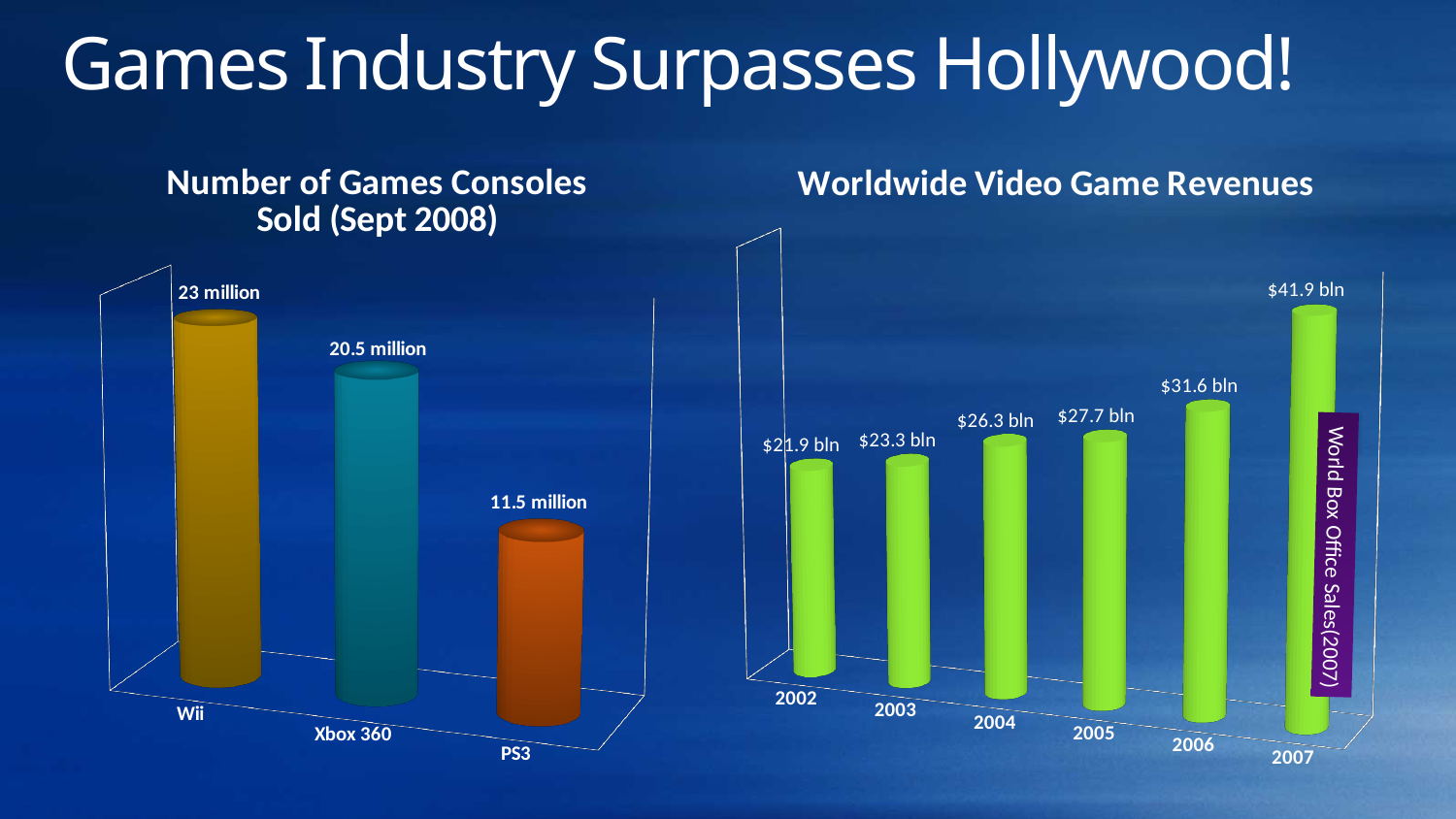
In the 'Worldwide Video Game Revenues' chart, do revenues rise or fall from 2002 to 2007? rise In the 'Number of Games Consoles Sold (Sept 2008)' chart, how many consoles were sold for the Wii? 23 million In the 'Number of Games Consoles Sold (Sept 2008)' chart, which console has the lowest number sold? PS3 In the 'Worldwide Video Game Revenues' chart, what is the difference between the 2007 and 2006 revenues? $10.3 bln In the 'Number of Games Consoles Sold (Sept 2008)' chart, what is the value for the PS3? 11.5 million What kind of chart is the 'Worldwide Video Game Revenues' chart? bar chart In the 'Number of Games Consoles Sold (Sept 2008)' chart, what is the difference between the Wii and Xbox 360 values? 2.5 million In the 'Worldwide Video Game Revenues' chart, which year has the lowest revenue? 2002 In the 'Worldwide Video Game Revenues' chart, what is the revenue for 2005? $27.7 bln In the 'Worldwide Video Game Revenues' chart, what is the revenue for 2007? $41.9 bln In the 'Number of Games Consoles Sold (Sept 2008)' chart, which console has the highest number sold? Wii In the 'Number of Games Consoles Sold (Sept 2008)' chart, how many consoles are shown? 3